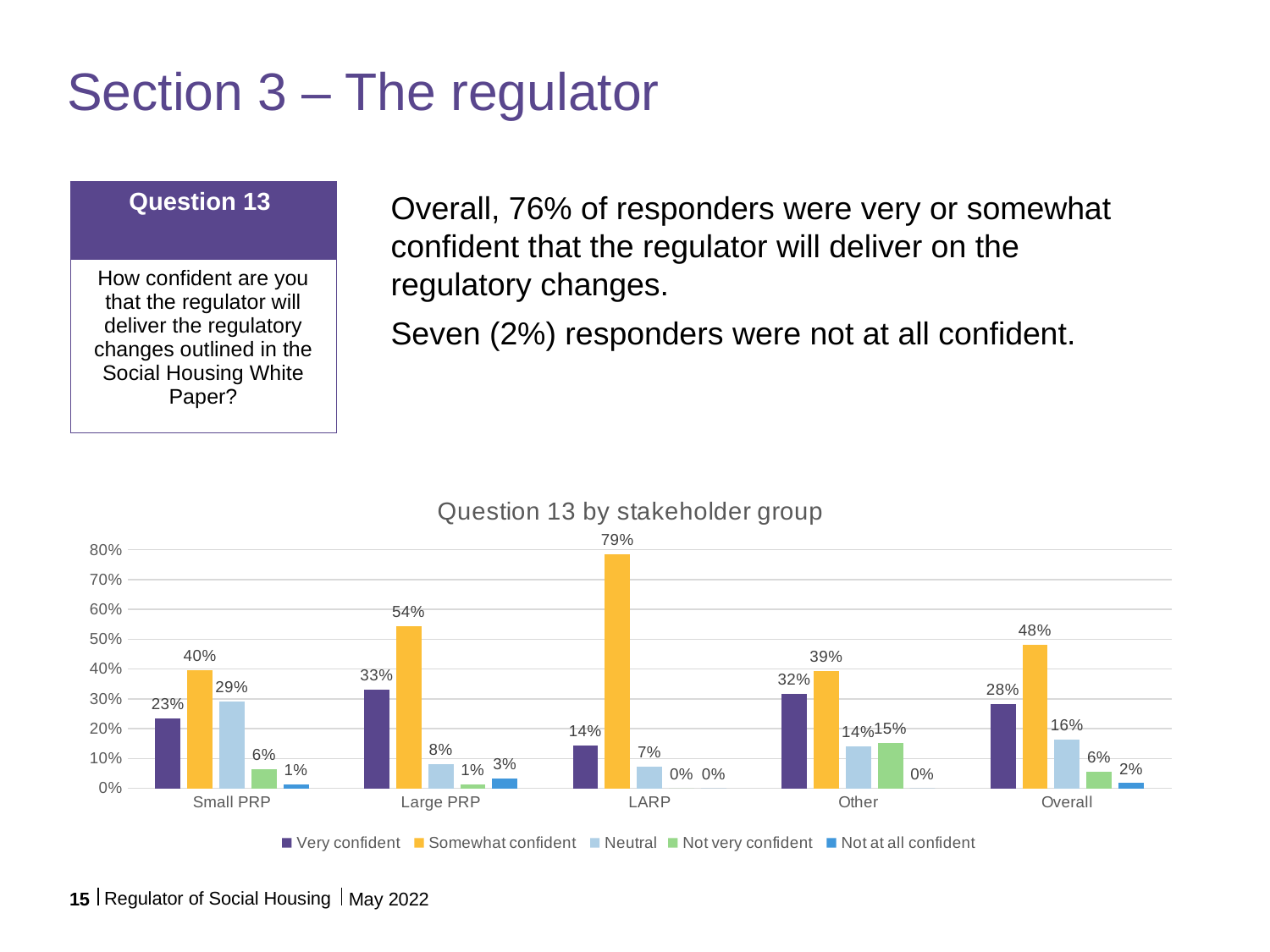
What is the value for Not at all confident in the Overall group? 2% How many stakeholder groups are shown on the x axis? 5 How many series does the legend list? 5 Which is larger in the Other group: Neutral or Not very confident? Not very confident What is the value for Somewhat confident in the LARP group? 79% What is the value for Neutral in the Small PRP group? 29% What is the value for Very confident in the Large PRP group? 33% Which stakeholder group has the highest Somewhat confident value? LARP What is the title of the chart? Question 13 by stakeholder group What is the difference between the Somewhat confident and Very confident values in the Overall group? 20% Which stakeholder group has the lowest Very confident value? LARP What kind of chart is shown on the slide? Bar chart